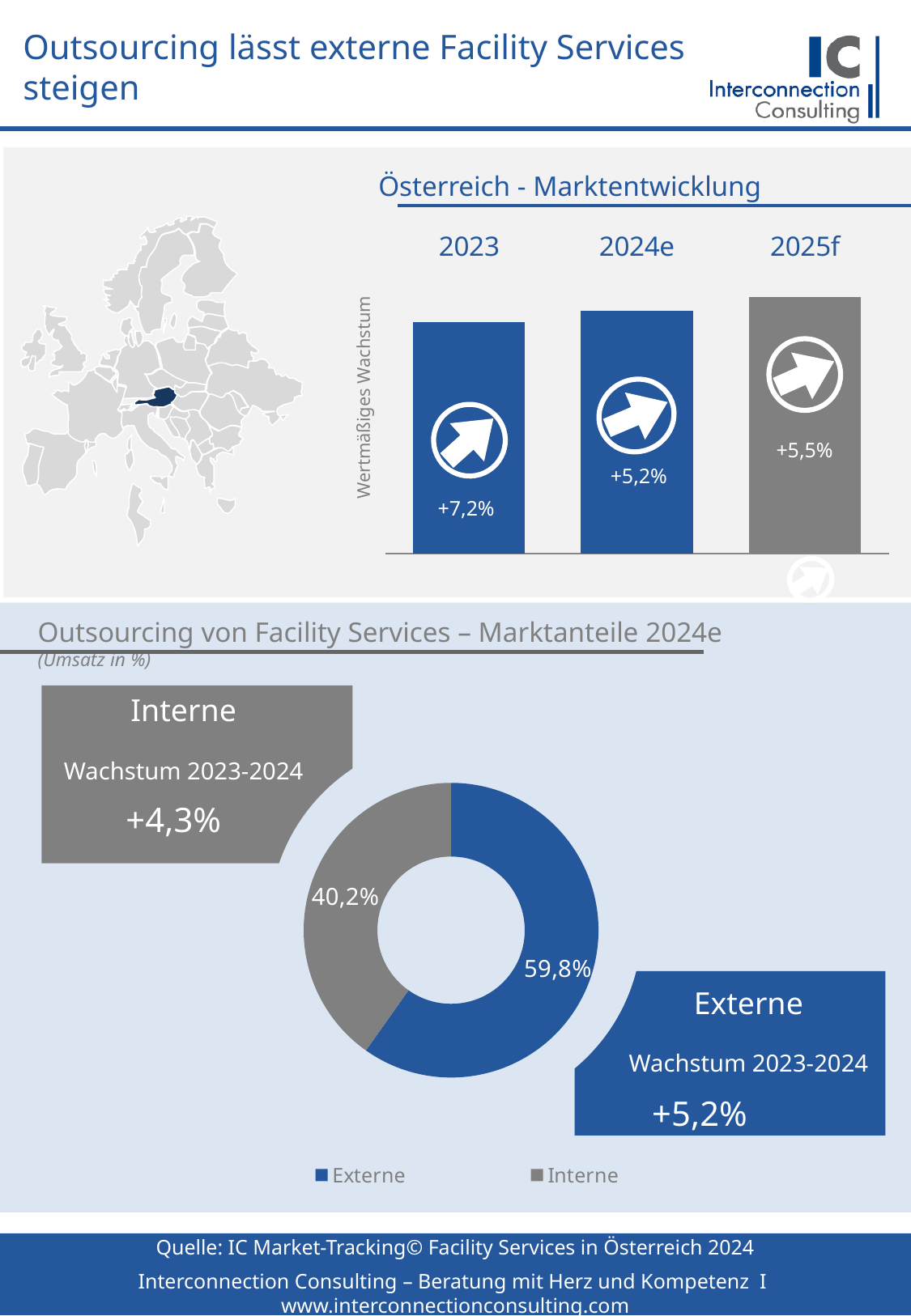
How many entries does the legend of the 'Marktanteile 2024e' donut chart list? 2 What is the y-axis label of the 'Österreich - Marktentwicklung' chart? Wertmäßiges Wachstum What kind of chart is 'Outsourcing von Facility Services – Marktanteile 2024e'? Donut (pie) chart In the 'Marktanteile 2024e' donut chart, what share does Interne have? 40,2% In the 'Marktanteile 2024e' donut chart, what share does Externe have? 59,8% What kind of chart is 'Österreich - Marktentwicklung'? Bar chart In the 'Österreich - Marktentwicklung' chart, what is the value shown for 2023? +7,2% How many years are shown in the 'Österreich - Marktentwicklung' chart? 3 In the 'Marktanteile 2024e' donut chart, which segment is larger, Externe or Interne? Externe In the 'Österreich - Marktentwicklung' chart, what is the value shown for 2025f? +5,5% In the 'Marktanteile 2024e' donut chart, what is the difference in percentage points between the Externe and Interne shares? 19,6 In the 'Österreich - Marktentwicklung' chart, what is the value shown for 2024e? +5,2%